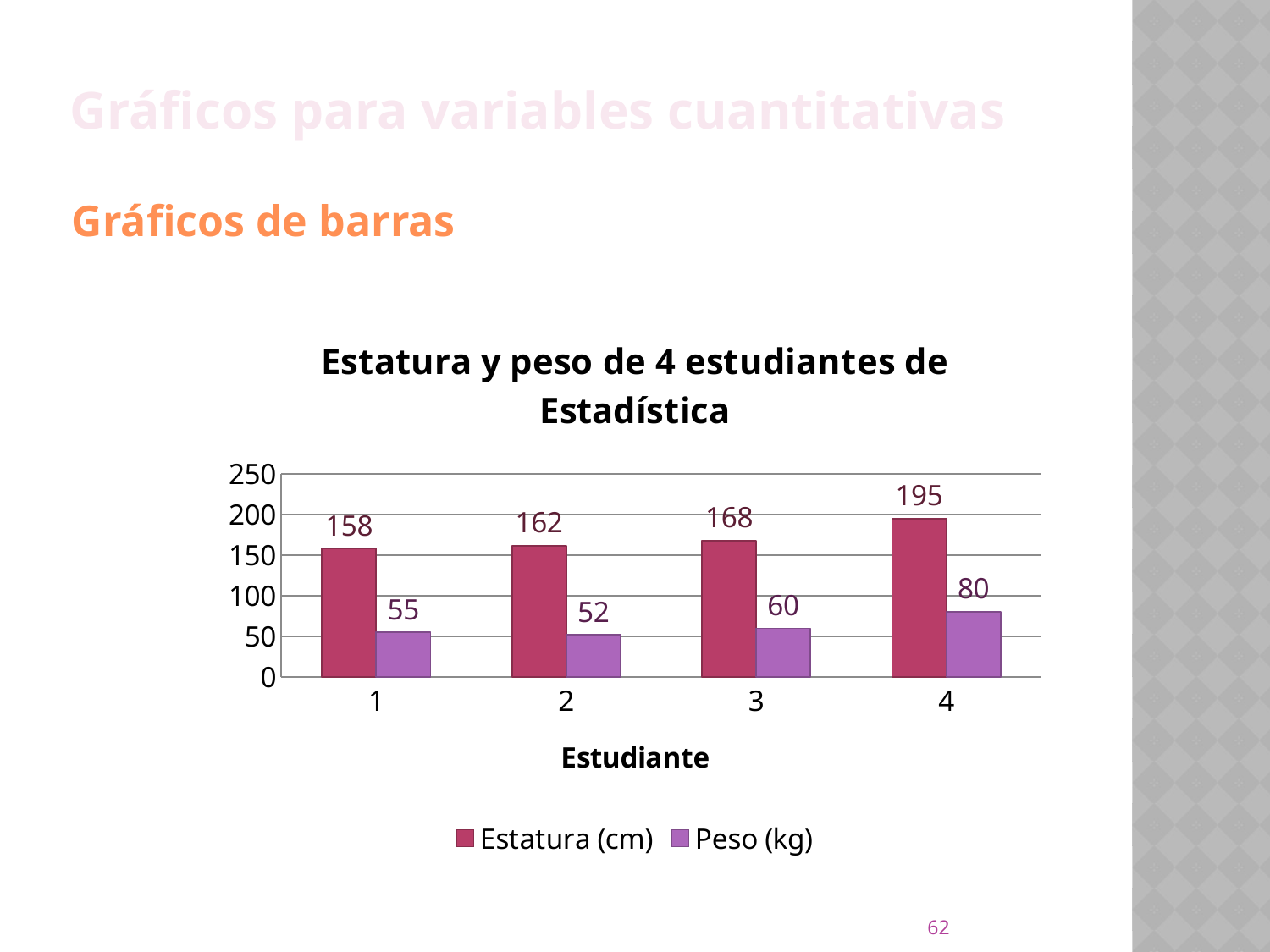
What is the Estatura (cm) value for Estudiante 1? 158 How many students (categories) are shown on the x axis? 4 Which Estudiante has the highest Estatura (cm)? 4 Which Estudiante has the lowest Peso (kg)? 2 Is the Estatura (cm) value for Estudiante 3 greater or less than 150? greater What is the Peso (kg) value for Estudiante 4? 80 How many series does the legend list? 2 What is the difference in Estatura (cm) between Estudiante 4 and Estudiante 1? 37 What is the Peso (kg) value for Estudiante 3? 60 What kind of chart is shown on the slide? bar chart Which is larger, the Peso (kg) of Estudiante 1 or of Estudiante 2? Estudiante 1 What is the title of the chart? Estatura y peso de 4 estudiantes de Estadística